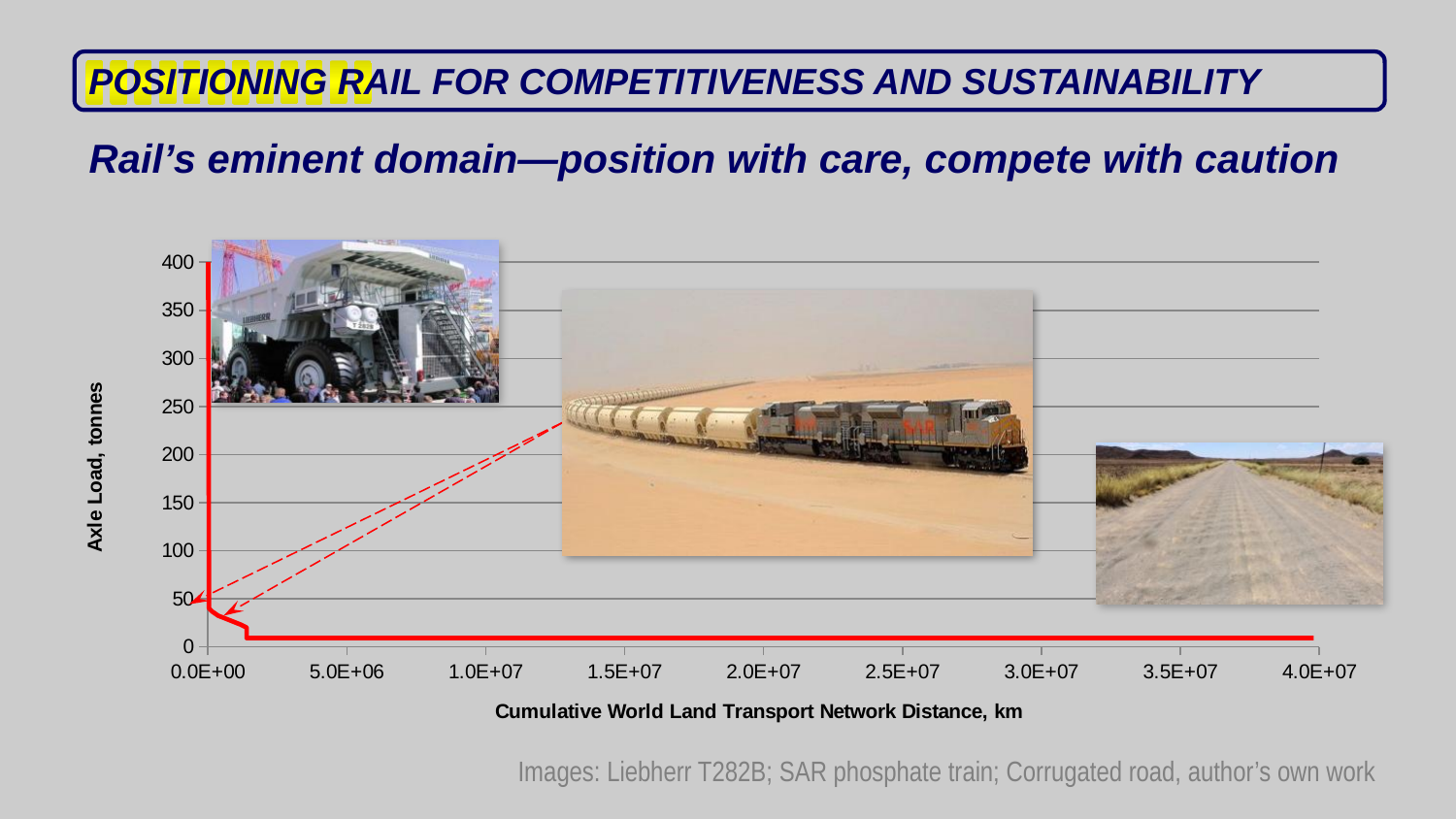
What is the label of the vertical axis of the chart? Axle Load, tonnes Does the plotted axle load rise or fall as cumulative network distance increases along the x axis? fall Is the axle load value at a cumulative distance of 2.0E+07 km greater or less than 50 tonnes? less How many tick labels are shown on the horizontal axis of the chart? 9 Is the axle load value at a cumulative distance of 3.0E+07 km greater or less than 100 tonnes? less Which is larger: the axle load plotted near a cumulative distance of 0.0E+00 km or the axle load plotted at 3.5E+07 km? near 0.0E+00 km How many tick labels are shown on the vertical axis of the chart? 9 What is the label of the horizontal axis of the chart? Cumulative World Land Transport Network Distance, km What kind of chart is shown on the slide? line chart Is the axle load value at a cumulative distance of 1.0E+07 km greater or less than 50 tonnes? less